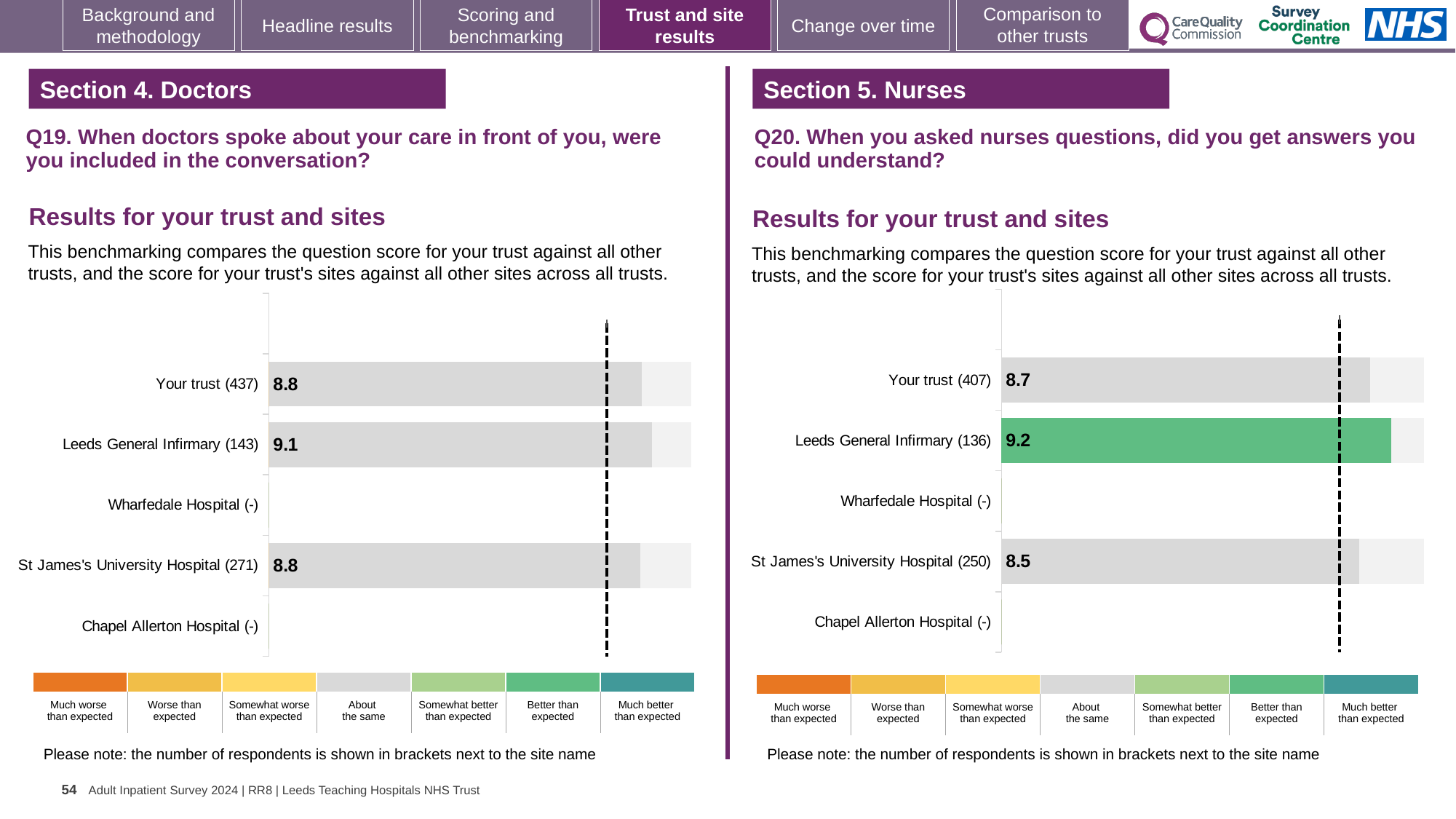
On the Q20 chart (nurses), which site has the highest score? Leeds General Infirmary On the Q20 chart (nurses), which of the scored sites has the lowest score? St James's University Hospital On the Q20 chart (nurses), which is higher: the score for Your trust or the score for St James's University Hospital? Your trust On the Q19 chart (doctors), what is the score for Leeds General Infirmary? 9.1 On the Q19 chart (doctors), what is the difference between the Leeds General Infirmary score and the Your trust score? 0.3 On the Q19 chart (doctors), what is the score for Your trust? 8.8 How many site or trust rows are listed on the Q19 chart (doctors)? 5 On the Q20 chart (nurses), what is the score for Leeds General Infirmary? 9.2 What type of chart is used on the Q19 chart (doctors)? Bar chart On the Q20 chart (nurses), how many respondents are shown in brackets for Your trust? 407 On the Q20 chart (nurses), what is the difference between the Leeds General Infirmary score and the St James's University Hospital score? 0.7 On the Q20 chart (nurses), what is the score for St James's University Hospital? 8.5